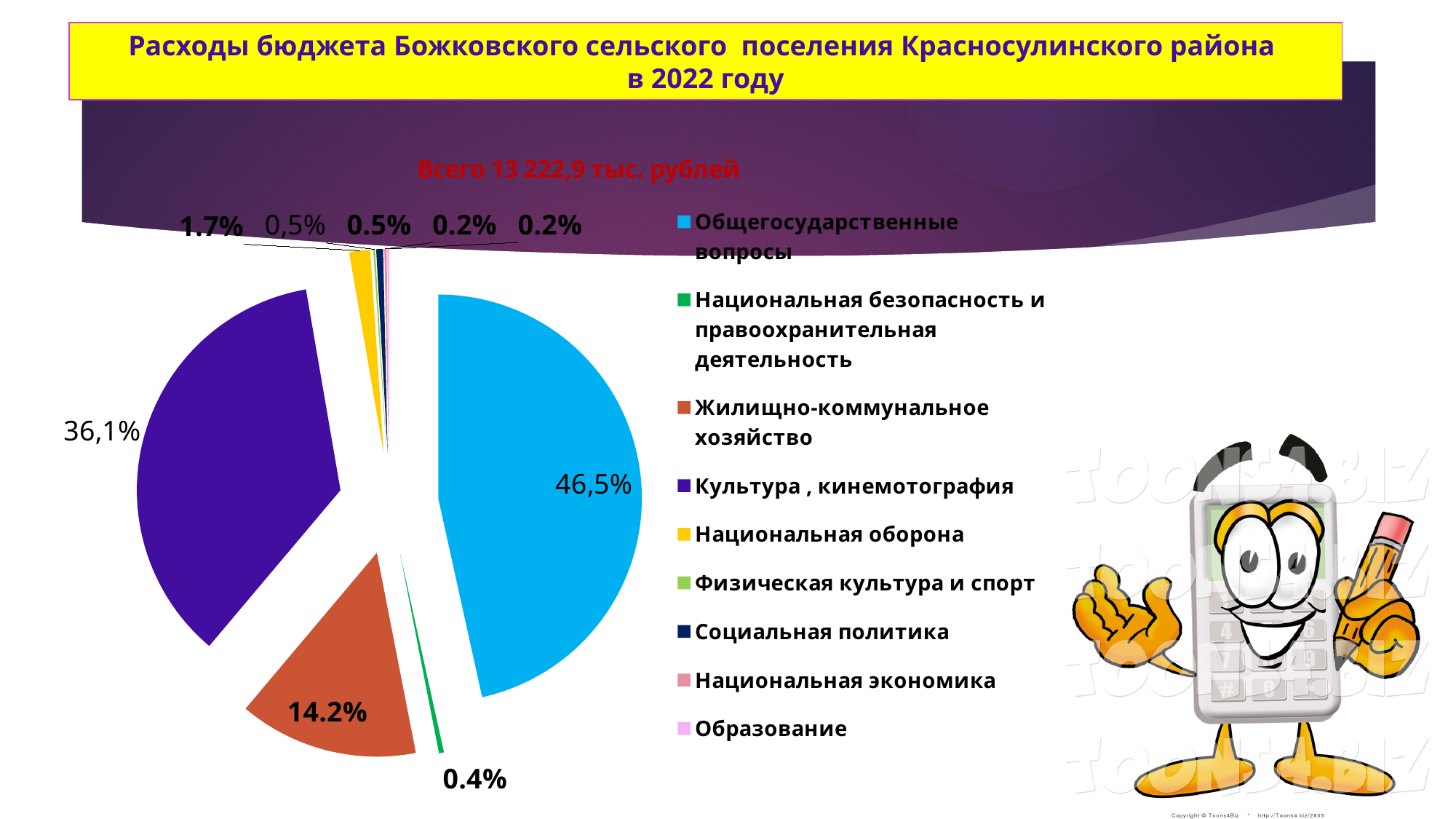
By how many percentage points does the share for Общегосударственные вопросы exceed the share for Культура, кинемотография? 10,4 Which category has the largest share of the pie? Общегосударственные вопросы What kind of chart is shown on the slide? Pie chart What share of the budget expenditure goes to Национальная безопасность и правоохранительная деятельность? 0.4% What share of the budget expenditure goes to Культура, кинемотография? 36,1% What share of the budget expenditure goes to Жилищно-коммунальное хозяйство? 14.2% What share of the budget expenditure goes to Общегосударственные вопросы? 46,5% What colour is the slice for Общегосударственные вопросы? Blue What share of the budget expenditure goes to Национальная оборона? 1.7% Which is larger: the share for Культура, кинемотография or for Жилищно-коммунальное хозяйство? Культура, кинемотография What total expenditure amount is stated above the chart? 13 222,9 тыс. рублей How many categories does the legend list? 9